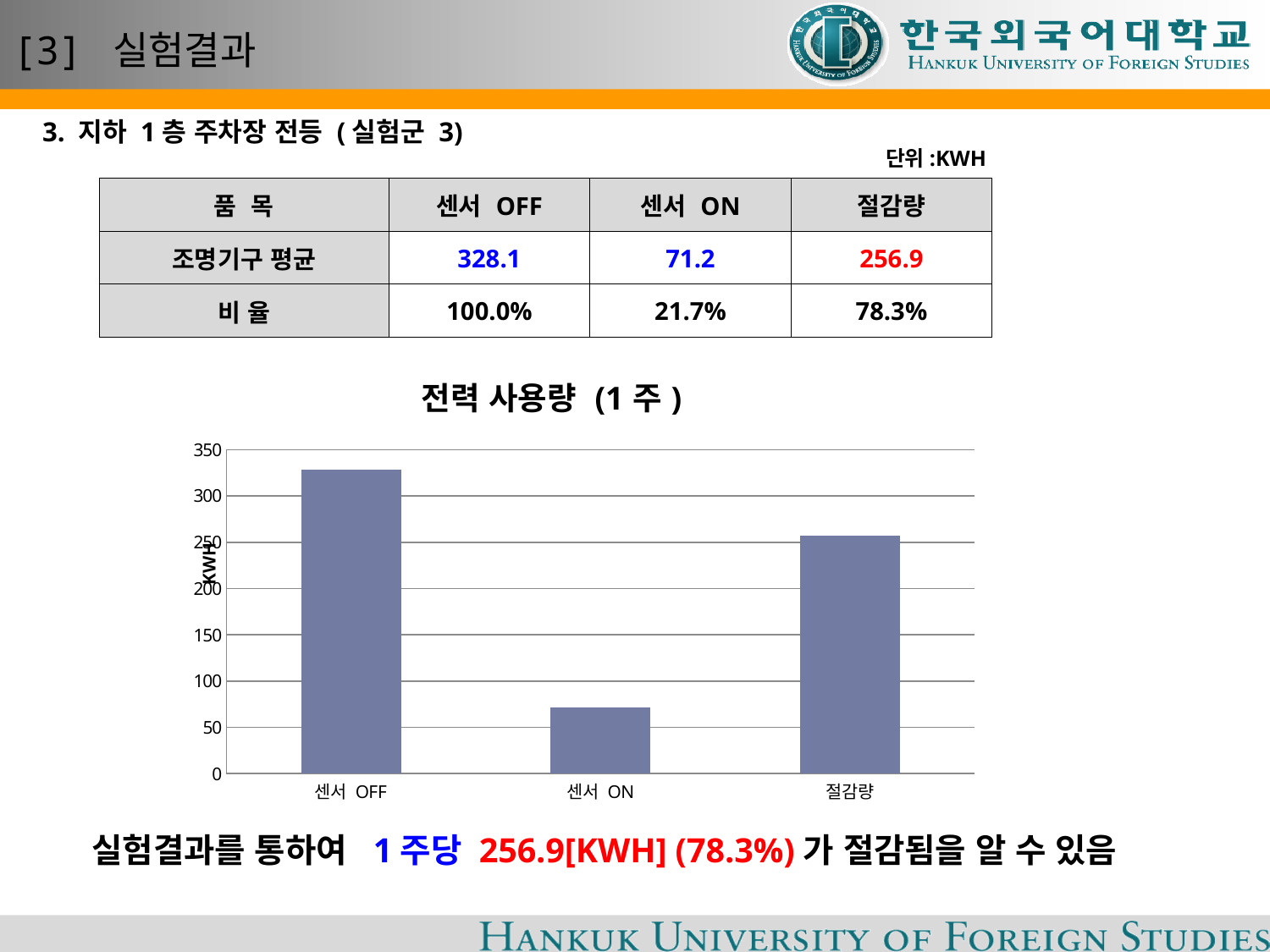
What is the title of the chart? 전력 사용량 (1 주 ) Which is larger, the bar for 센서 ON or the bar for 절감량? 절감량 Which category has the lowest bar in the chart? 센서 ON What is the label on the vertical axis of the chart? KWH Which category has the highest bar in the chart? 센서 OFF Is the value for 센서 OFF greater or less than 300? greater What kind of chart is shown on the slide? bar chart According to the slide, what is the value for 센서 OFF in KWH? 328.1 How many bars does the chart have? 3 Is the value for 센서 ON greater or less than 100? less Is the value for 절감량 greater or less than 250? greater According to the slide, what is the value for 절감량 in KWH? 256.9